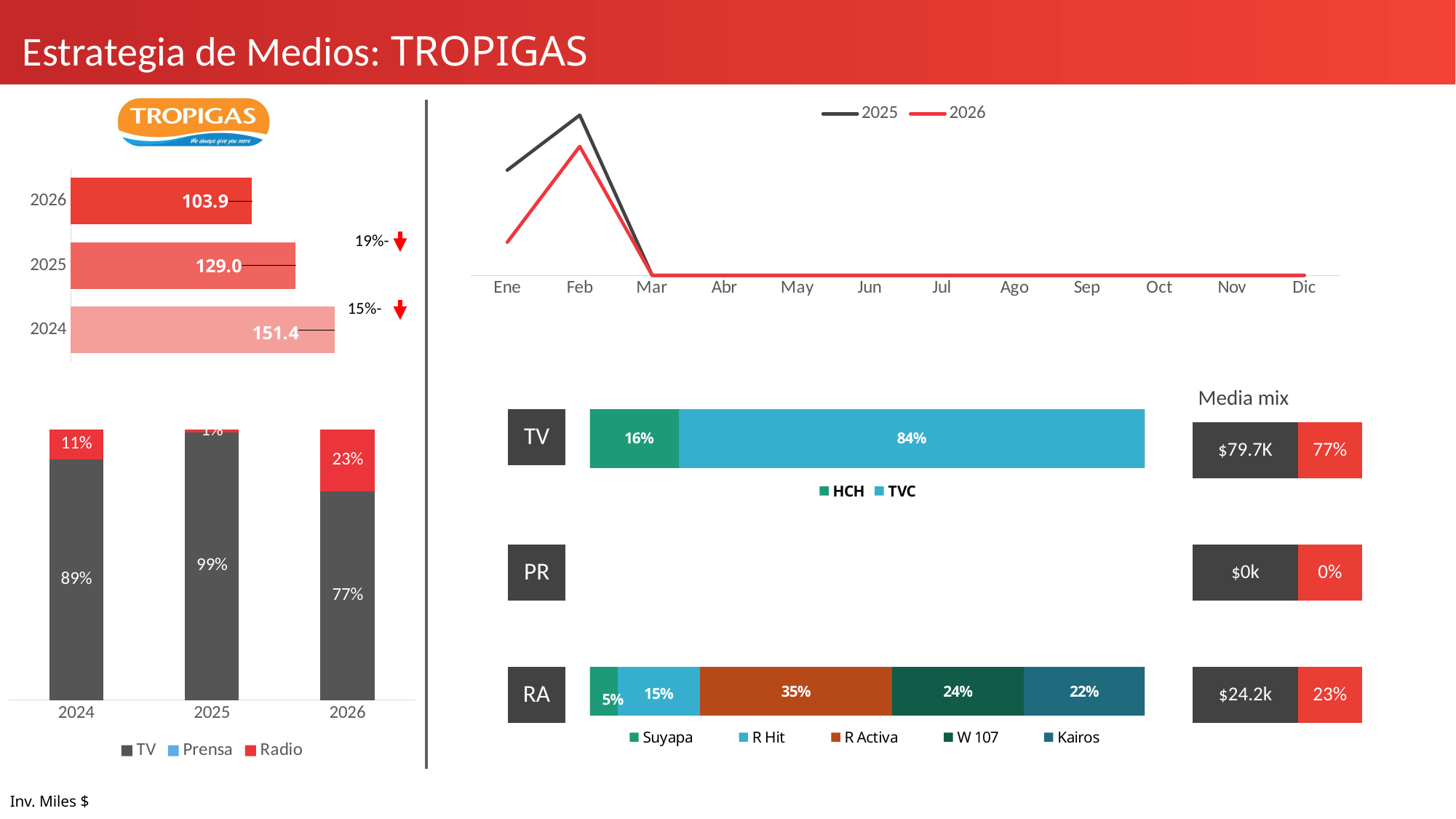
In the horizontal bar chart at the top left, what is the difference between the 2025 and 2026 values? 25.1 In the stacked bar chart at the bottom left, what is the Radio share for 2026? 23% In the line chart at the top right, how many months are shown on the x axis? 12 In the TV stacked bar on the right, what is the share for TVC? 84% In the line chart at the top right, which month has the highest value for the 2025 series? Feb In the RA stacked bar on the right, which station has the largest share? R Activa In the horizontal bar chart at the top left, do the values rise or fall from 2024 to 2026? fall In the stacked bar chart at the bottom left, what is the TV share for 2025? 99% How many series does the legend of the stacked bar chart at the bottom left list? 3 In the horizontal bar chart at the top left, which year has the highest value? 2024 In the horizontal bar chart at the top left, what is the value for 2026? 103.9 In the horizontal bar chart at the top left, what is the value for 2024? 151.4